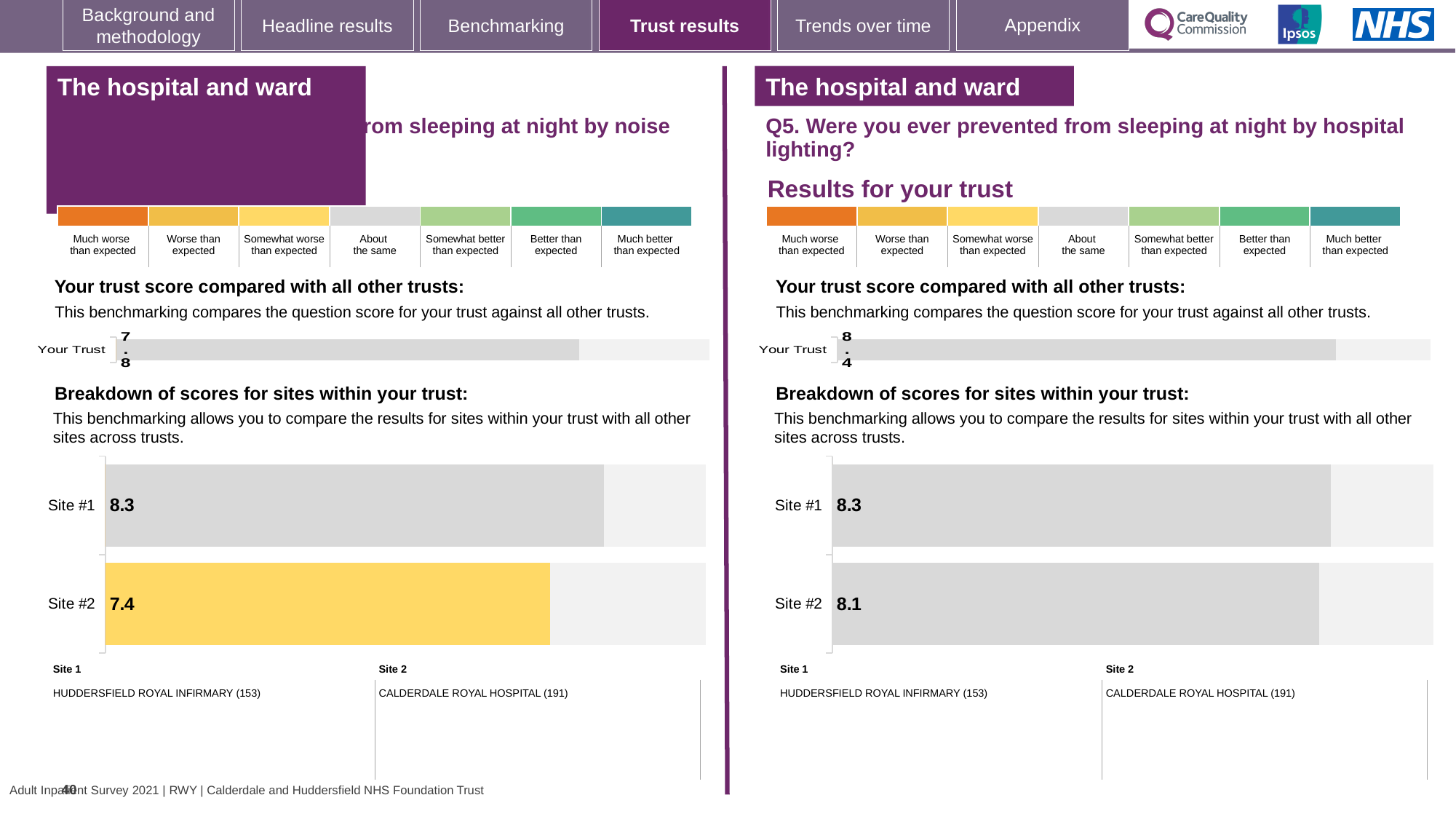
On the right-hand side of the slide (Q5, hospital lighting), what is the score shown for Site #2? 8.1 On the right-hand side of the slide (Q5, hospital lighting), what is the 'Your Trust' score in the trust score comparison chart? 8.4 On the left-hand side of the slide, what is the score shown for Site #2 in the breakdown of scores for sites within your trust? 7.4 On the left-hand side of the slide, what is the 'Your Trust' score in the trust score comparison chart? 7.8 In the right-hand site breakdown chart (Q5, hospital lighting), which site has the lower score? Site #2 How many sites are shown in the left-hand site breakdown chart? 2 What type of chart is used for the breakdown of scores for sites within your trust on the right-hand side of the slide? Bar chart On the right-hand side of the slide (Q5, hospital lighting), what is the score shown for Site #1? 8.3 On the left-hand side of the slide, what is the score shown for Site #1 in the breakdown of scores for sites within your trust? 8.3 In the right-hand site breakdown chart (Q5, hospital lighting), what is the difference between the Site #1 and Site #2 scores? 0.2 In the left-hand site breakdown chart, what is the difference between the Site #1 and Site #2 scores? 0.9 In the left-hand site breakdown chart, which site has the higher score? Site #1